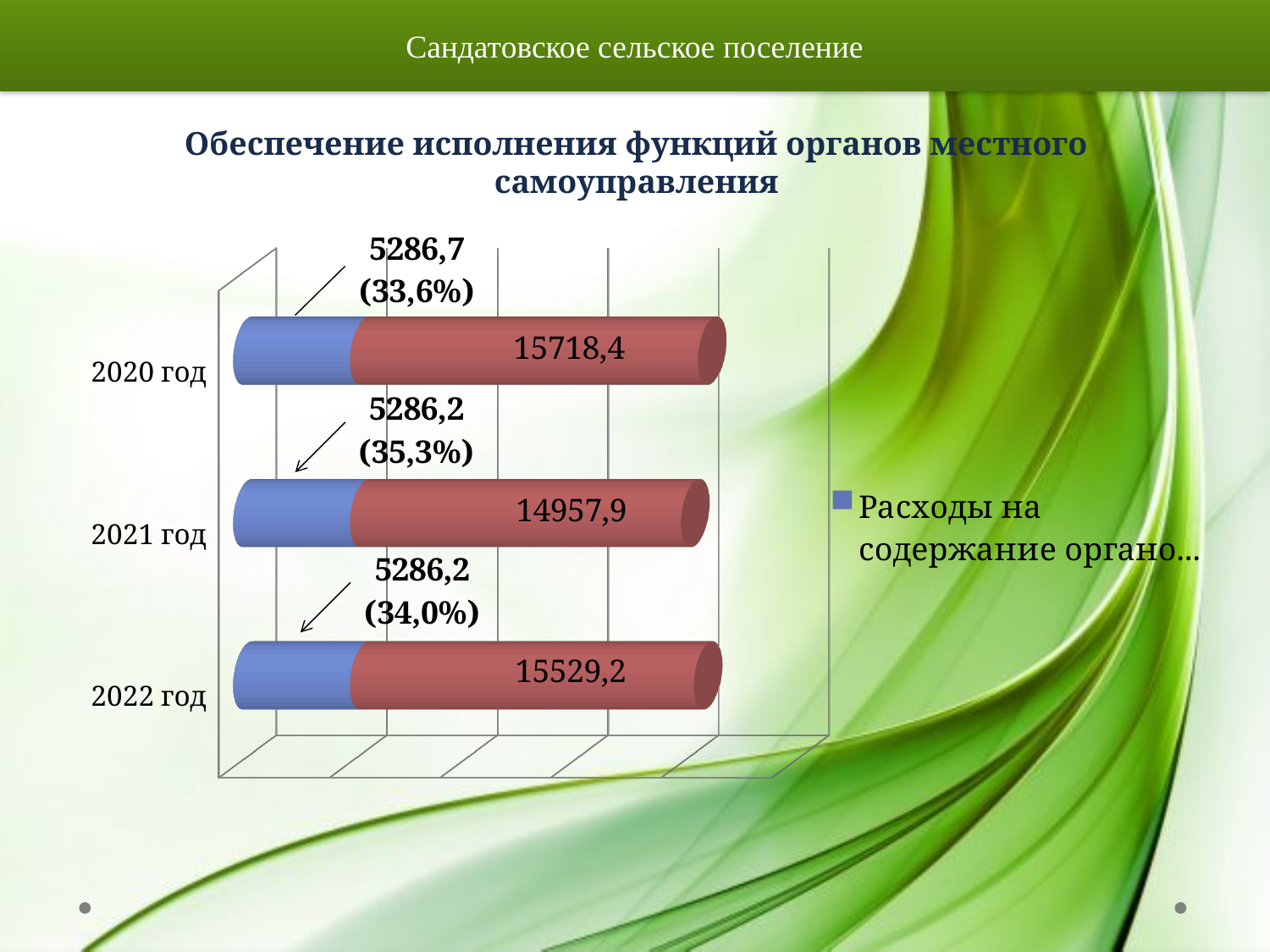
What is the difference between the red segment values for 2020 год and 2021 год? 760,5 What is the value of the red bar segment for 2022 год? 15529,2 What percentage is shown next to the blue segment for 2022 год? 34,0% Which year has the larger red segment value, 2021 год or 2022 год? 2022 год What type of chart is shown on the slide? Bar chart What percentage is shown next to the blue segment for 2021 год? 35,3% Which year has the lowest value on the red bar segment? 2021 год Which year has the highest value on the red bar segment? 2020 год What value is labelled on the blue bar segment for 2020 год? 5286,7 How many years are shown on the chart? 3 What is the value of the red bar segment for 2020 год? 15718,4 What is the value of the red bar segment for 2021 год? 14957,9